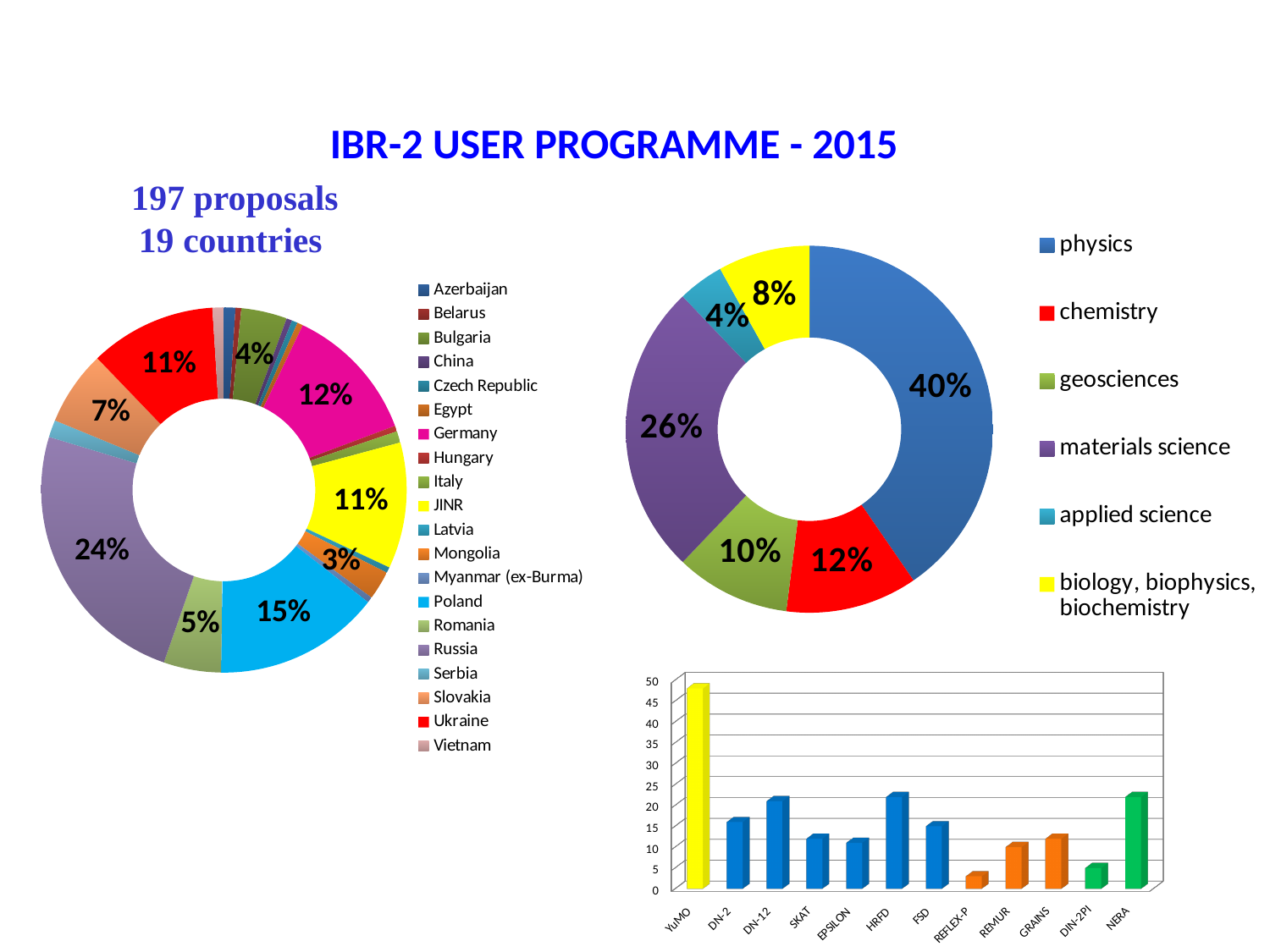
In the left doughnut chart (countries), how many countries does the legend list? 19 In the left doughnut chart (countries), which is larger, the share for Germany or the share for Slovakia? Germany In the right doughnut chart (science fields), what share is labelled for physics? 40% In the bottom bar chart, is the value for REFLEX-P greater or less than 5? less In the right doughnut chart (science fields), how many entries does the legend list? 6 In the right doughnut chart (science fields), what is the difference between the physics share and the chemistry share? 28% In the left doughnut chart (countries), what share is labelled for Russia? 24% In the right doughnut chart (science fields), which field has the smallest share? applied science In the right doughnut chart (science fields), what share is labelled for materials science? 26% What kind of chart is the chart at the bottom right of the slide? bar chart In the left doughnut chart (countries), what share is labelled for Poland? 15% In the bottom bar chart, which instrument has the highest bar? YuMO